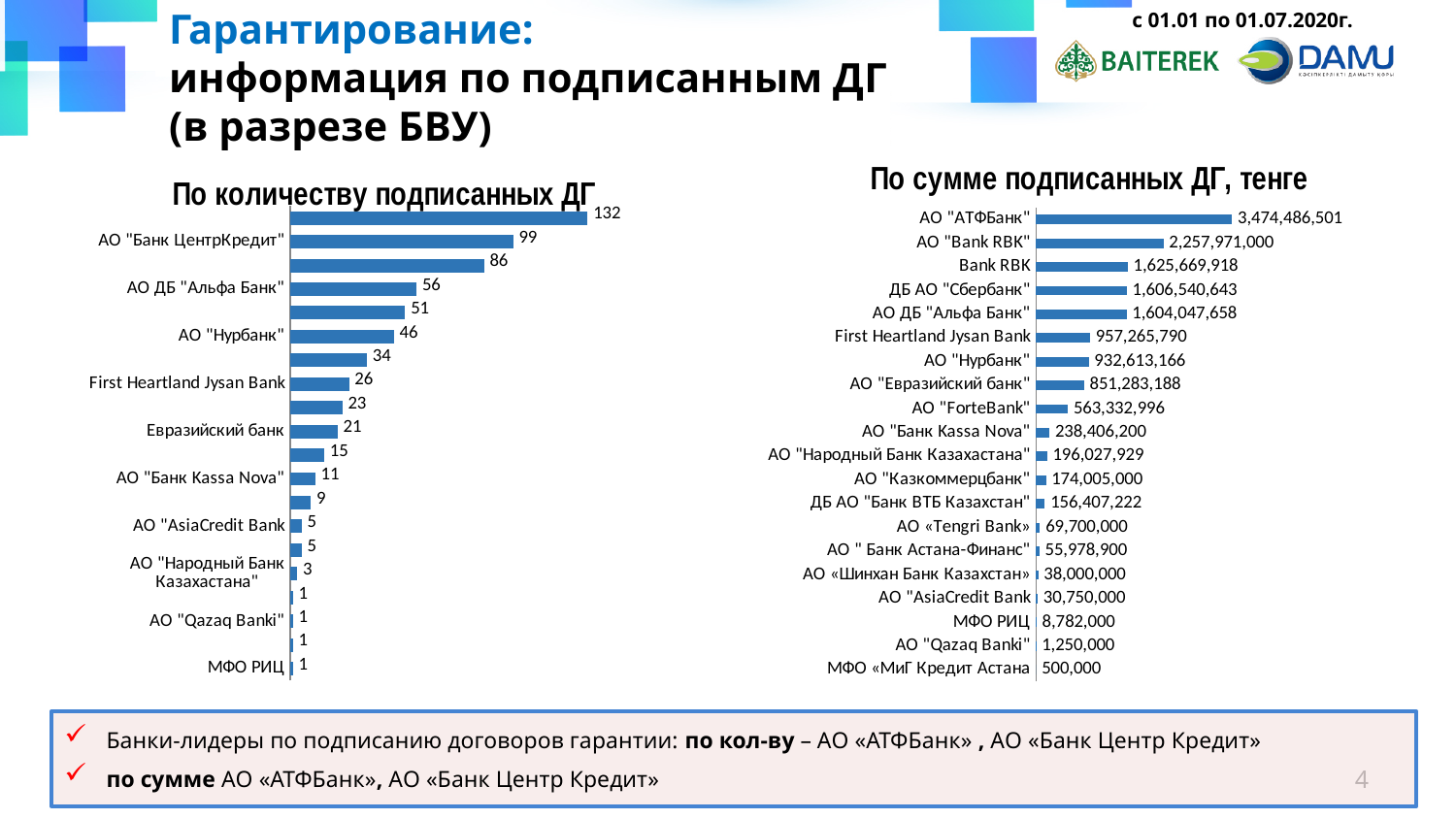
In the chart "По количеству подписанных ДГ", what is the value for АО "Банк ЦентрКредит"? 99 In the chart "По количеству подписанных ДГ", which is larger: АО ДБ "Альфа Банк" or First Heartland Jysan Bank? АО ДБ "Альфа Банк" In the chart "По сумме подписанных ДГ, тенге", how many categories are plotted? 20 In the chart "По количеству подписанных ДГ", what is the value for АО "Нурбанк"? 46 In the chart "По количеству подписанных ДГ", what is the difference between АО "Банк ЦентрКредит" and Евразийский банк? 78 What type of chart is "По сумме подписанных ДГ, тенге"? Bar chart In the chart "По сумме подписанных ДГ, тенге", which category has the highest value? АО "АТФБанк" In the chart "По количеству подписанных ДГ", how many bars are plotted? 20 In the chart "По сумме подписанных ДГ, тенге", what is the value for ДБ АО "Сбербанк"? 1,606,540,643 In the chart "По сумме подписанных ДГ, тенге", which category has the lowest value? МФО «МиГ Кредит Астана» In the chart "По сумме подписанных ДГ, тенге", what is the difference between АО "Bank RBK" and Bank RBK? 632,301,082 In the chart "По сумме подписанных ДГ, тенге", what is the value for АО "АТФБанк"? 3,474,486,501